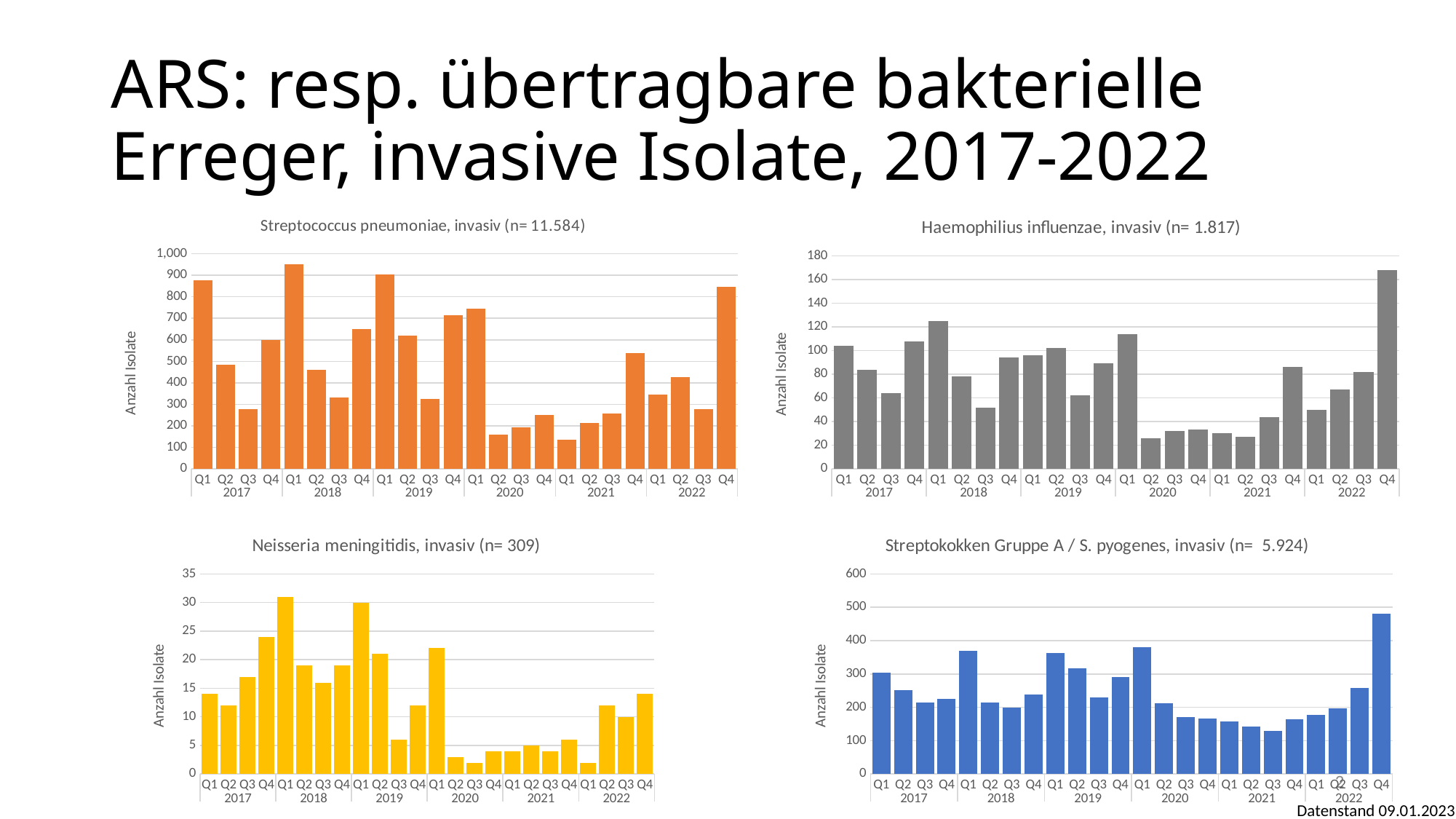
How many quarterly bars are plotted in the Neisseria meningitidis chart? 24 In the Haemophilius influenzae chart, is the value for Q4 2022 greater or less than 160? greater In the Streptococcus pneumoniae chart, is the value for Q1 2017 greater or less than 800? greater In the Neisseria meningitidis chart, is the value for Q1 2019 greater or less than 25? greater In the Haemophilius influenzae chart, which is larger, the value for Q1 2018 or the value for Q3 2018? Q1 2018 In the Neisseria meningitidis chart, which quarter has the highest number of isolates? Q1 2018 In the Streptokokken Gruppe A / S. pyogenes chart, which quarter has the highest number of isolates? Q4 2022 In the Streptokokken Gruppe A / S. pyogenes chart, which quarter has the lowest number of isolates? Q3 2021 In the Haemophilius influenzae chart, which quarter has the highest number of isolates? Q4 2022 What type of chart is used for the Haemophilius influenzae data? Bar chart